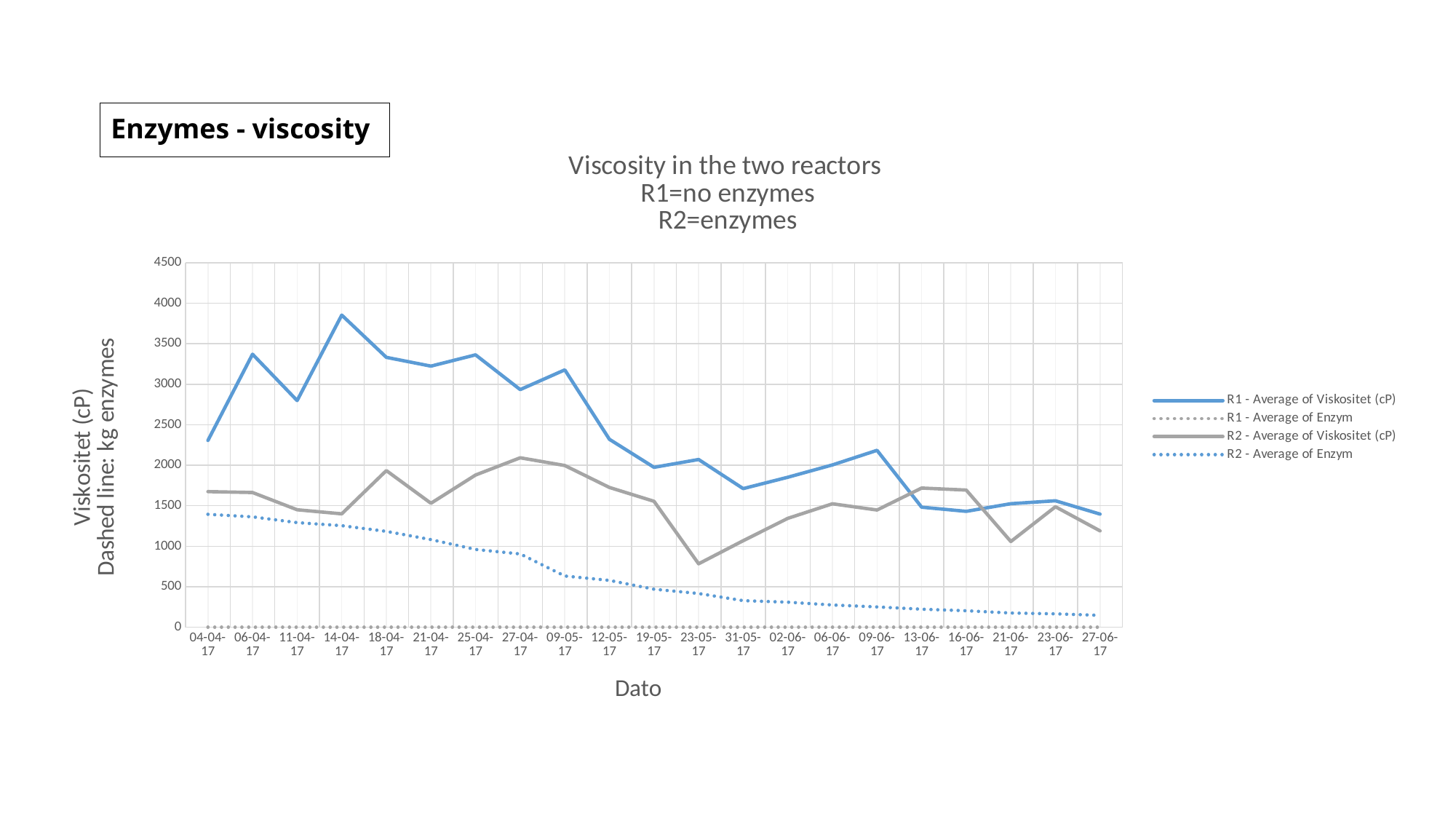
What is the title of the chart? Viscosity in the two reactors R1=no enzymes R2=enzymes Which series has the larger value on 04-04-17: R1 - Average of Viskositet (cP) or R2 - Average of Viskositet (cP)? R1 - Average of Viskositet (cP) How many dates are shown on the x axis? 21 Is the value of R2 - Average of Viskositet (cP) on 23-05-17 greater or less than 1000? less What is the label of the x axis? Dato Does the R2 - Average of Enzym series generally rise or fall from 04-04-17 to 27-06-17? fall Is the value of R1 - Average of Viskositet (cP) on 14-04-17 greater or less than 3500? greater Is the value of R2 - Average of Enzym on 27-06-17 greater or less than 500? less What kind of chart is shown on the slide? line chart On which date does the R2 - Average of Viskositet (cP) series reach its lowest value? 23-05-17 How many series does the legend list? 4 On which date does the R1 - Average of Viskositet (cP) series reach its highest value? 14-04-17